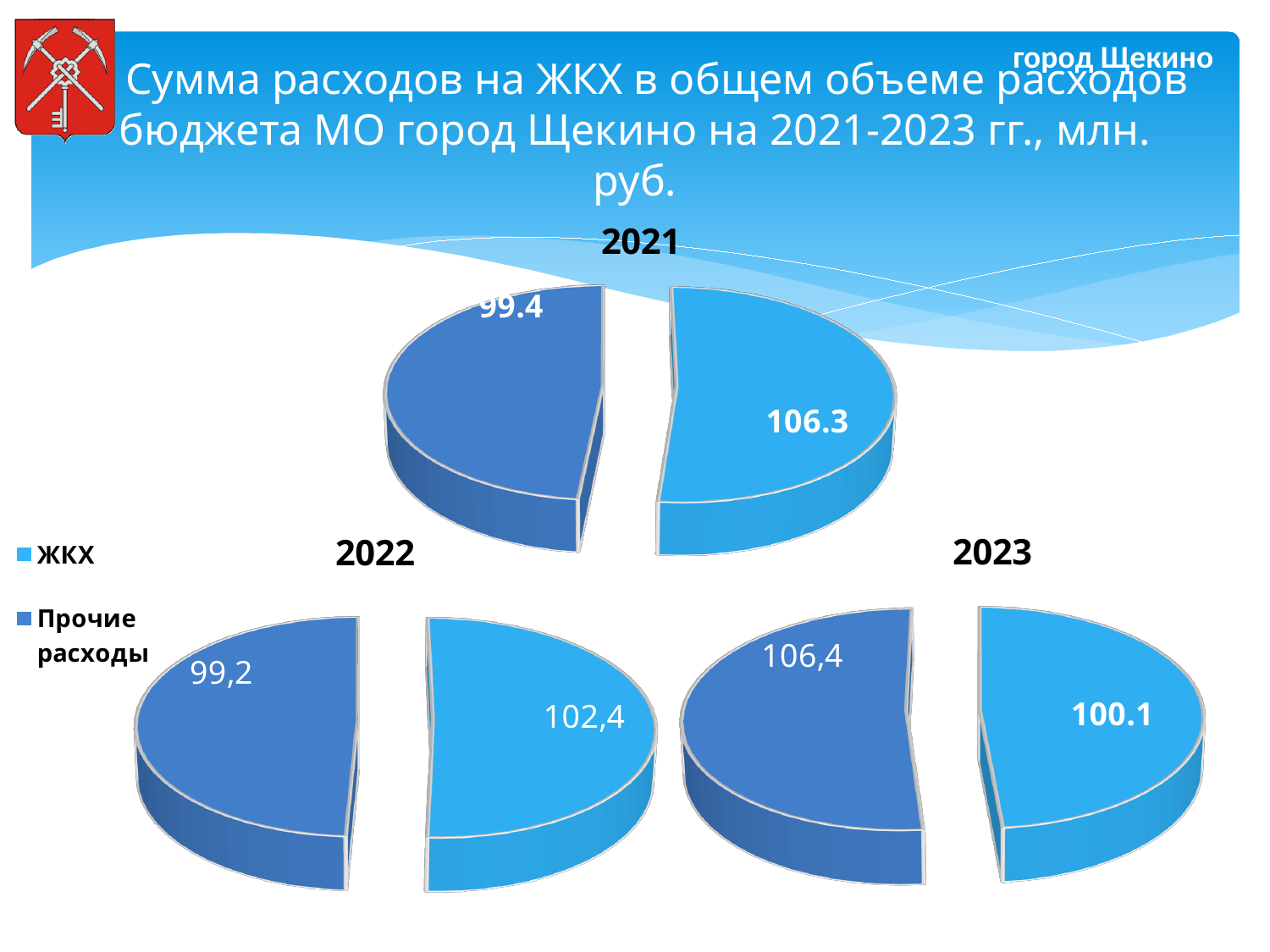
How many pie charts are shown on the slide? 3 In the 2021 pie chart, what is the value for Прочие расходы? 99.4 In the 2021 pie chart, what is the value for ЖКХ? 106.3 In the 2023 pie chart, which slice is larger, ЖКХ or Прочие расходы? Прочие расходы In the 2023 pie chart, what is the value for Прочие расходы? 106,4 How many entries does the legend list? 2 In the 2022 pie chart, what is the difference between the ЖКХ value and the Прочие расходы value? 3,2 In the 2023 pie chart, what is the value for ЖКХ? 100.1 In the 2021 pie chart, what is the difference between the ЖКХ value and the Прочие расходы value? 6.9 In the 2022 pie chart, what is the value for Прочие расходы? 99,2 What kind of chart is used for the 2022 data? Pie chart In the 2022 pie chart, what is the value for ЖКХ? 102,4